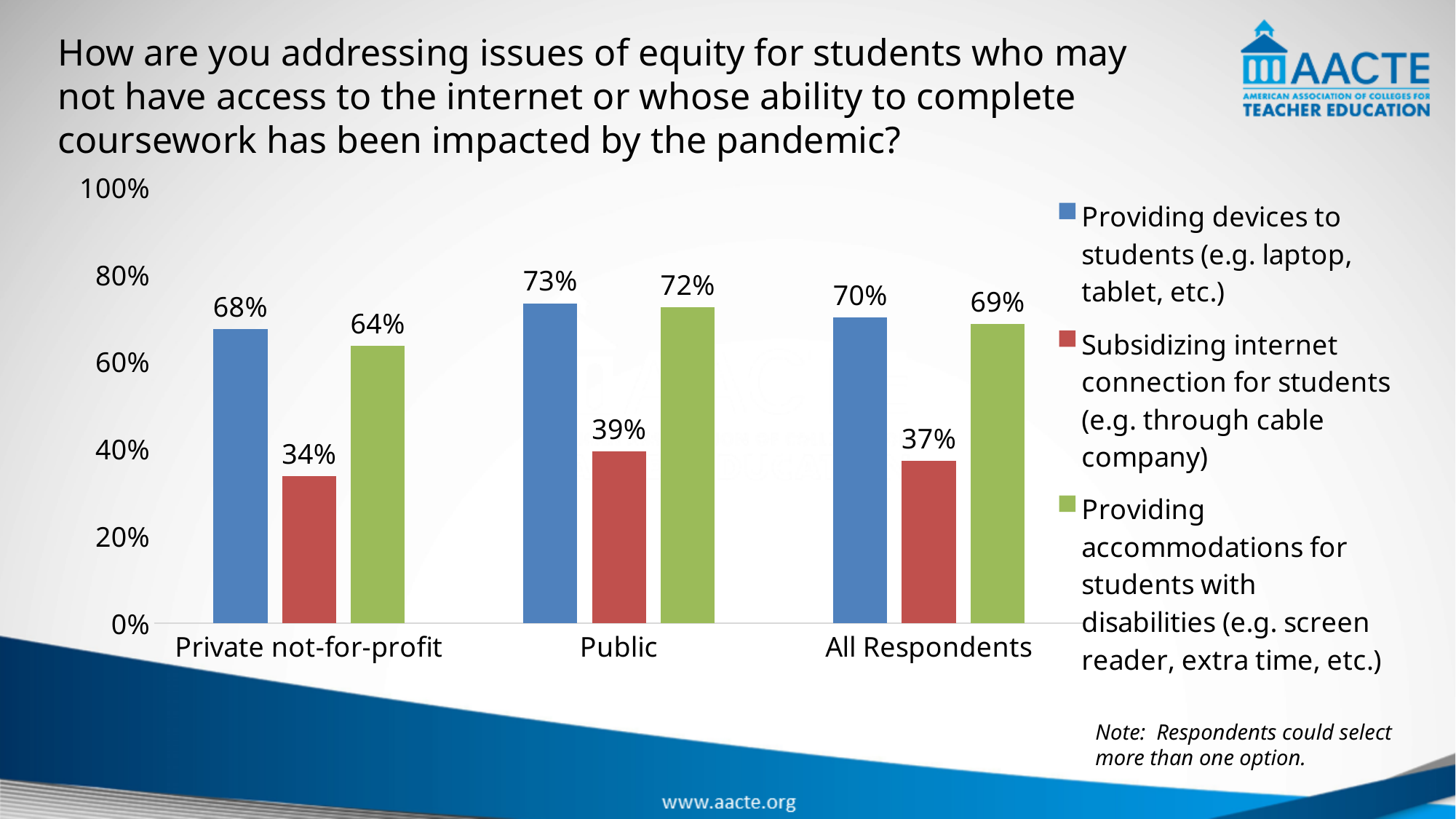
What percentage of All Respondents reported providing accommodations for students with disabilities? 69% What percentage of Public respondents reported providing devices to students? 73% How many series does the legend list? 3 What kind of chart is shown on the slide? Bar chart Which colour represents subsidizing internet connection for students in the legend? Red What is the value for subsidizing internet connection for students among Private not-for-profit respondents? 34% For All Respondents, which is larger: providing devices to students or subsidizing internet connection for students? Providing devices to students How many categories are shown on the x axis? 3 Is the value for subsidizing internet connection among Public respondents greater or less than 40%? less What is the difference between the Public and Private not-for-profit values for providing devices to students? 5% Which category has the lowest value for providing accommodations for students with disabilities? Private not-for-profit Which category has the highest value for subsidizing internet connection for students? Public